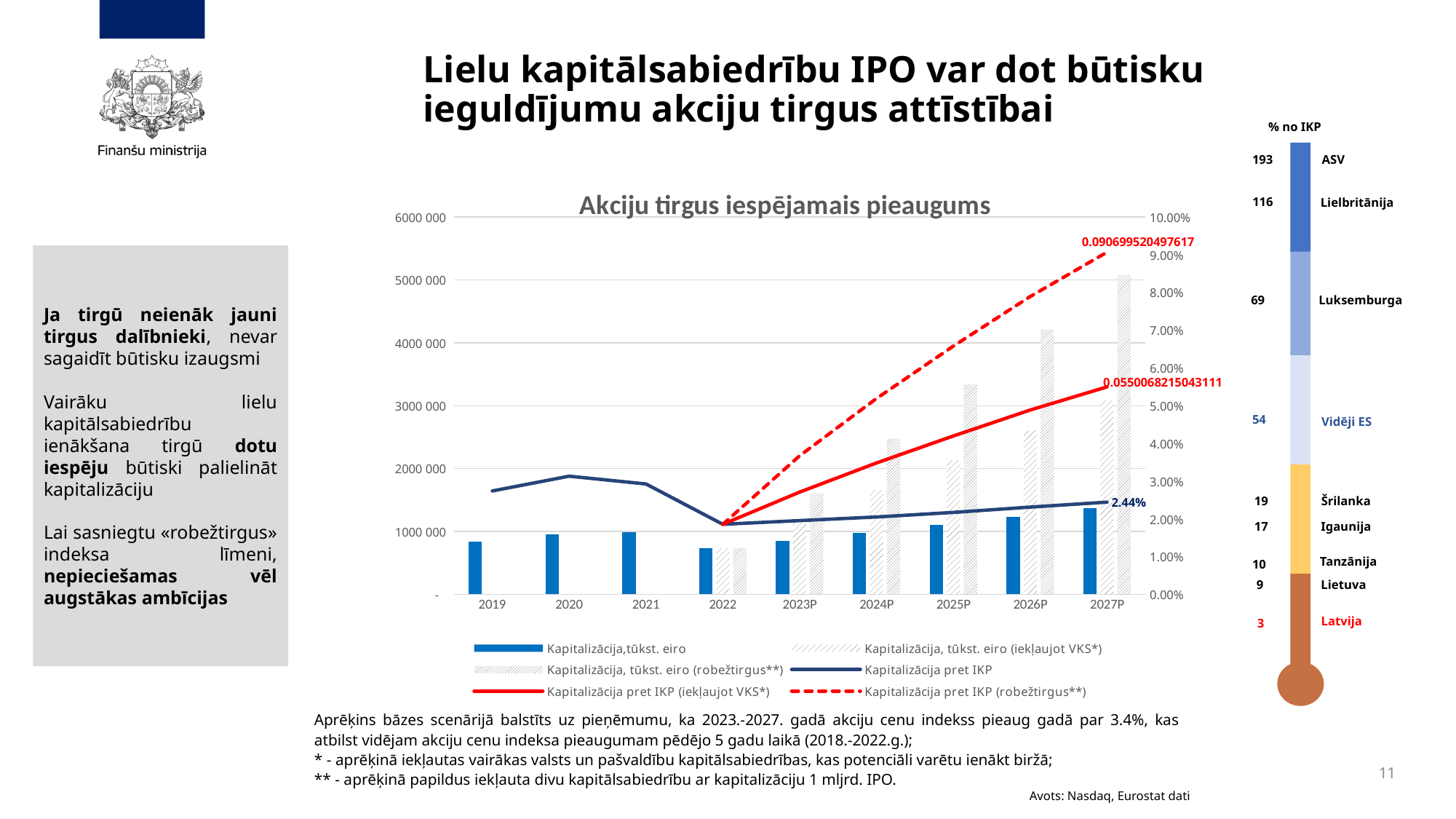
In the chart 'Akciju tirgus iespējamais pieaugums', what value is labelled at the end of the dashed red line 'Kapitalizācija pret IKP (robežtirgus**)' at 2027P? 0.090699520497617 In the chart 'Akciju tirgus iespējamais pieaugums', how many series does the legend list? 6 In the chart 'Akciju tirgus iespējamais pieaugums', is the 'Kapitalizācija, tūkst. eiro' bar for 2019 greater or less than 1000 000? less In the '% no IKP' graphic on the right, which country has the highest value? ASV In the chart 'Akciju tirgus iespējamais pieaugums', which year has the lowest 'Kapitalizācija, tūkst. eiro' bar? 2022 In the chart 'Akciju tirgus iespējamais pieaugums', how many years are shown on the x axis? 9 In the chart 'Akciju tirgus iespējamais pieaugums', is the 'Kapitalizācija, tūkst. eiro' bar for 2027P greater or less than 1000 000? greater In the chart 'Akciju tirgus iespējamais pieaugums', what value is labelled for 'Kapitalizācija pret IKP' at 2027P? 2.44% In the chart 'Akciju tirgus iespējamais pieaugums', what value is labelled at the end of the solid red line 'Kapitalizācija pret IKP (iekļaujot VKS*)' at 2027P? 0.0550068215043111 In the chart 'Akciju tirgus iespējamais pieaugums', what kind of chart is it? Combined bar and line chart In the chart 'Akciju tirgus iespējamais pieaugums', does the 'Kapitalizācija pret IKP' line rise or fall from 2022 to 2027P? rise In the '% no IKP' graphic on the right, what is the difference between the values for ASV and Latvija? 190